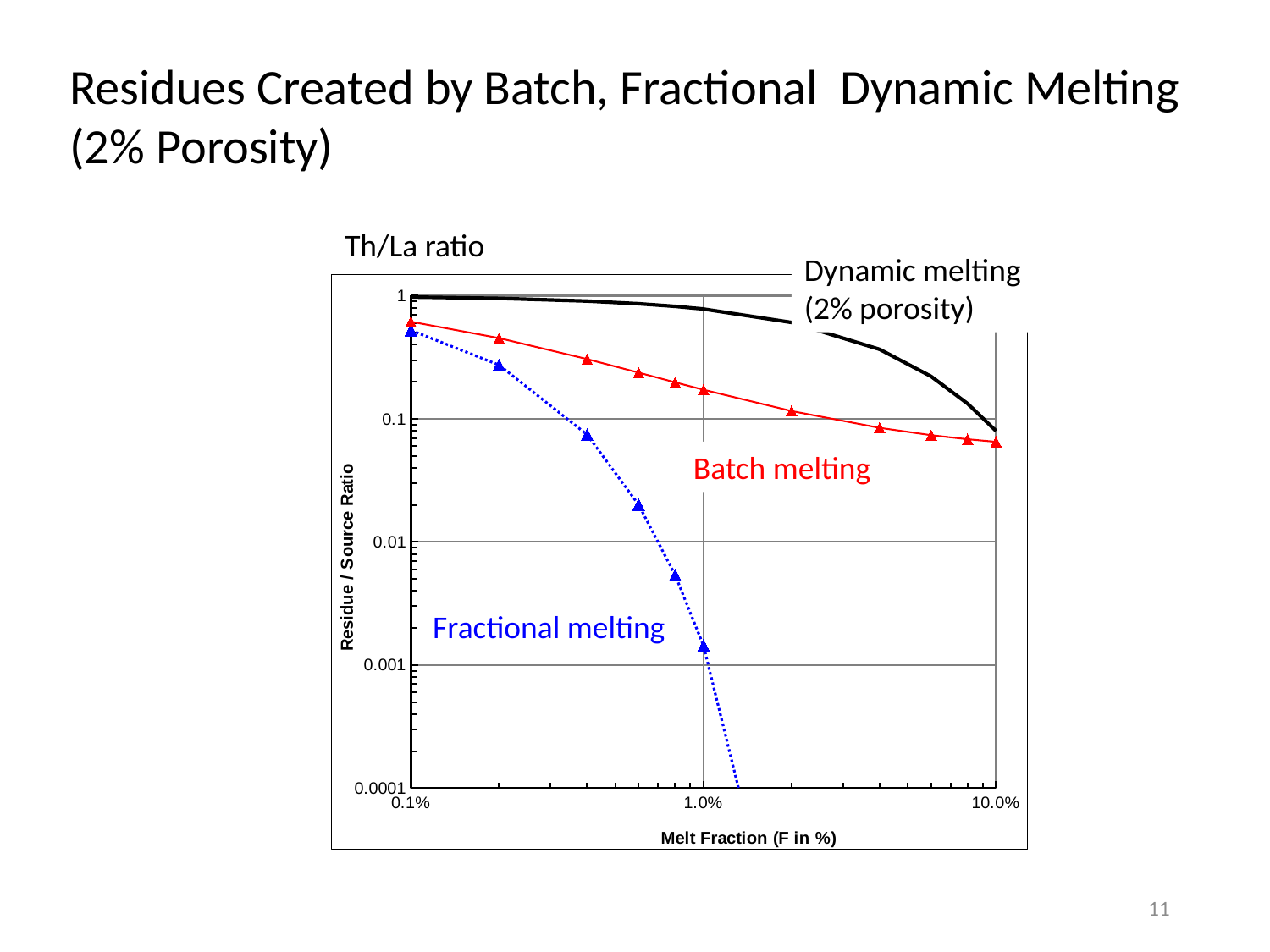
What kind of chart is shown on the slide? line chart Is the Batch melting value at a melt fraction of 1.0% greater or less than 0.1? greater Which series has the lowest value at a melt fraction of 1.0%? Fractional melting Is the Batch melting value at a melt fraction of 10.0% greater or less than 0.1? less Does the Batch melting curve rise or fall as melt fraction increases? fall At a melt fraction of 1.0%, which series has the higher value, Batch melting or Fractional melting? Batch melting Does the Fractional melting curve rise or fall as melt fraction increases? fall What is the label of the y axis of the chart? Residue / Source Ratio Is the Dynamic melting (2% porosity) value at a melt fraction of 1.0% greater or less than 0.1? greater What is the label of the x axis of the chart? Melt Fraction (F in %) How many series are plotted on the chart? 3